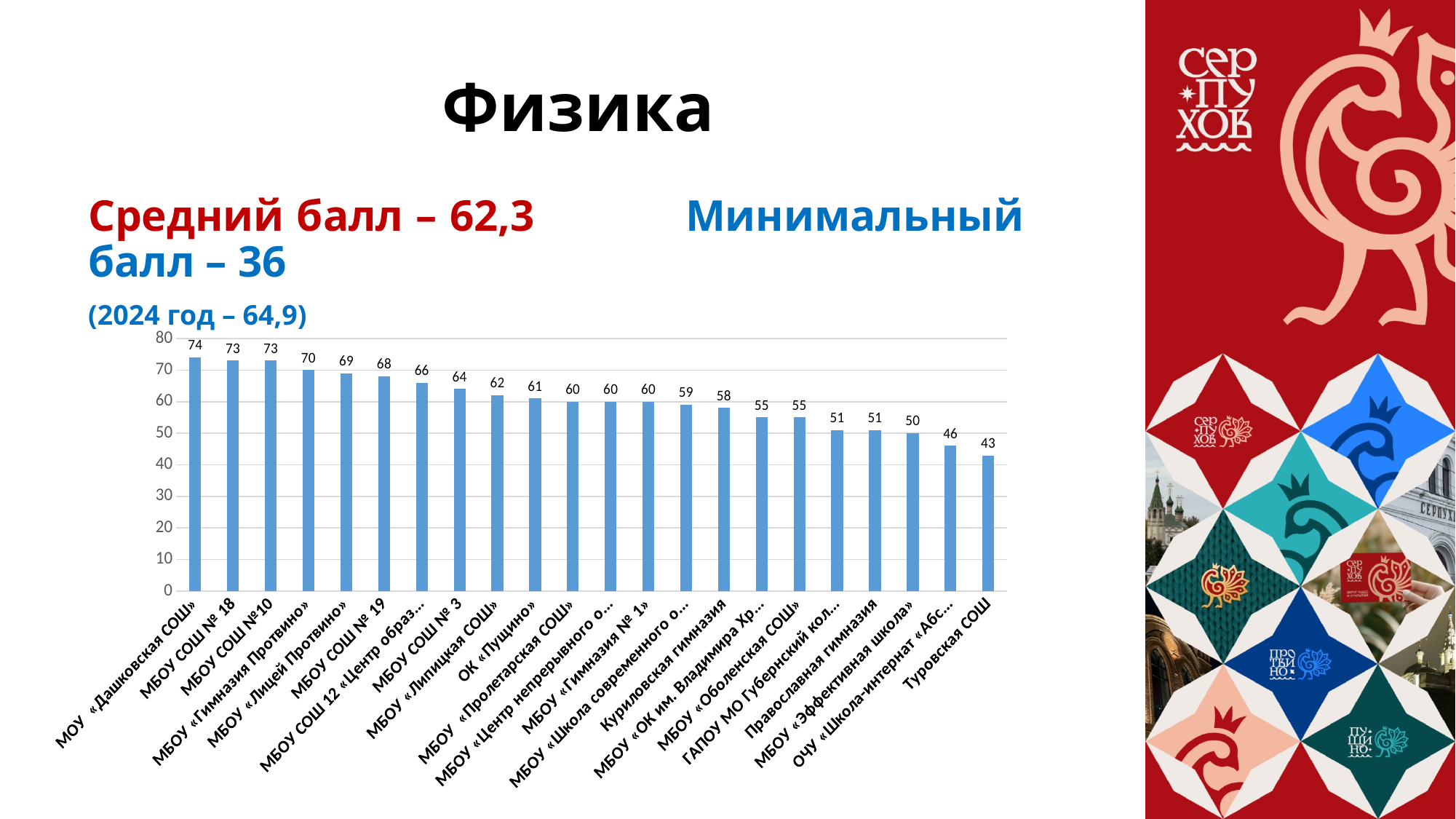
What is the title of the slide containing the chart? Физика Which is larger, the value for МБОУ «Гимназия Протвино» or the value for МБОУ СОШ № 19? МБОУ «Гимназия Протвино» What is the value for Куриловская гимназия? 58 What is the value for МБОУ «Эффективная школа»? 50 Do the values rise or fall from left to right along the x axis? fall Which category has the highest value? МОУ «Дашковская СОШ» What is the difference between the values for МОУ «Дашковская СОШ» and Туровская СОШ? 31 What is the value for Туровская СОШ? 43 What type of chart is shown on the slide? bar chart How many bars are plotted in the chart? 22 Which category has the lowest value? Туровская СОШ What is the value for МОУ «Дашковская СОШ»? 74